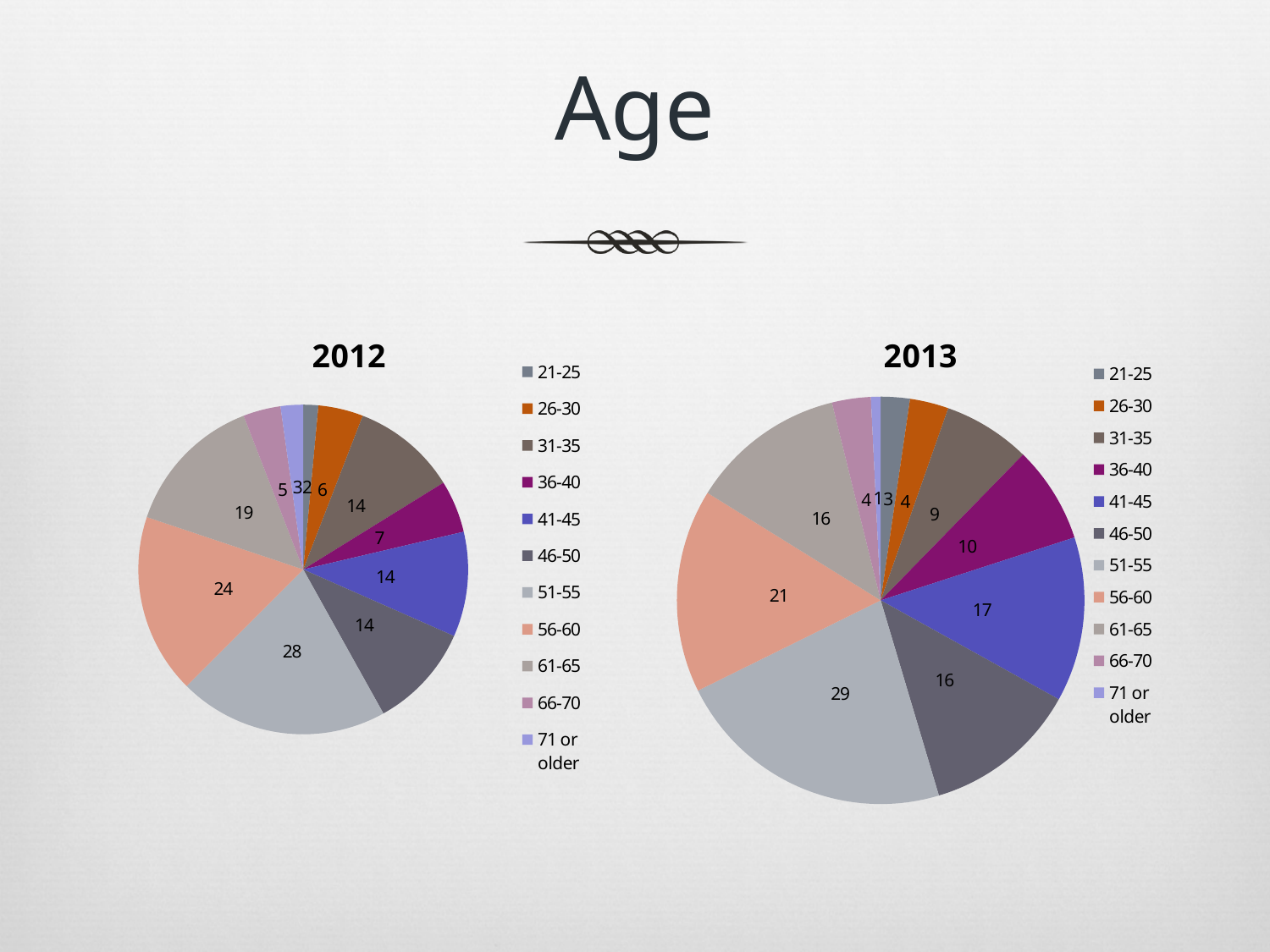
In the 2013 chart, which age group has the largest slice? 51-55 In the 2013 chart, which age group has the smallest slice? 71 or older What kind of chart is the 2012 chart? pie chart In the 2013 chart, what is the difference between the 51-55 value and the 56-60 value? 8 In the 2012 chart, what is the value for the 56-60 slice? 24 In the 2012 chart, which is larger, the 61-65 slice or the 36-40 slice? 61-65 How many age groups does the legend of the 2013 chart list? 11 In the 2013 chart, what is the value for the 36-40 slice? 10 In the 2012 chart, what is the value for the 51-55 slice? 28 What is the title of the chart on the left? 2012 In the 2013 chart, what is the value for the 41-45 slice? 17 In the 2012 chart, which age group has the largest slice? 51-55